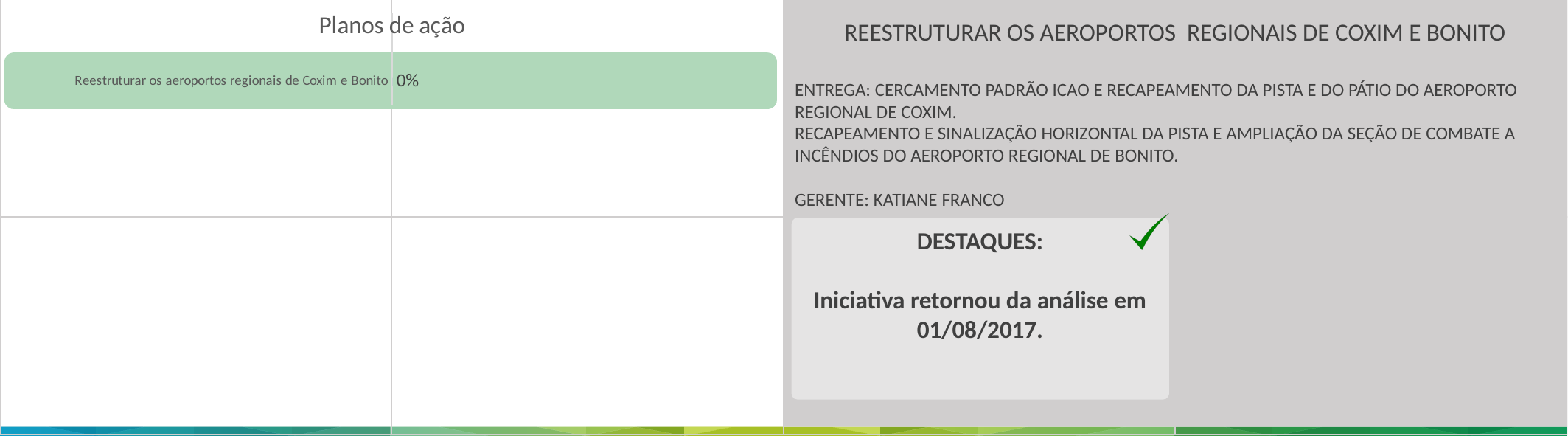
What is the title of the chart on the left side of the slide? Planos de ação What is the label of the only bar in the "Planos de ação" chart? Reestruturar os aeroportos regionais de Coxim e Bonito In the "Planos de ação" chart, is the value for "Reestruturar os aeroportos regionais de Coxim e Bonito" greater or less than 50%? less What kind of chart is the "Planos de ação" chart? bar chart In the "Planos de ação" chart, what value is shown for "Reestruturar os aeroportos regionais de Coxim e Bonito"? 0% How many categories are plotted in the "Planos de ação" chart? 1